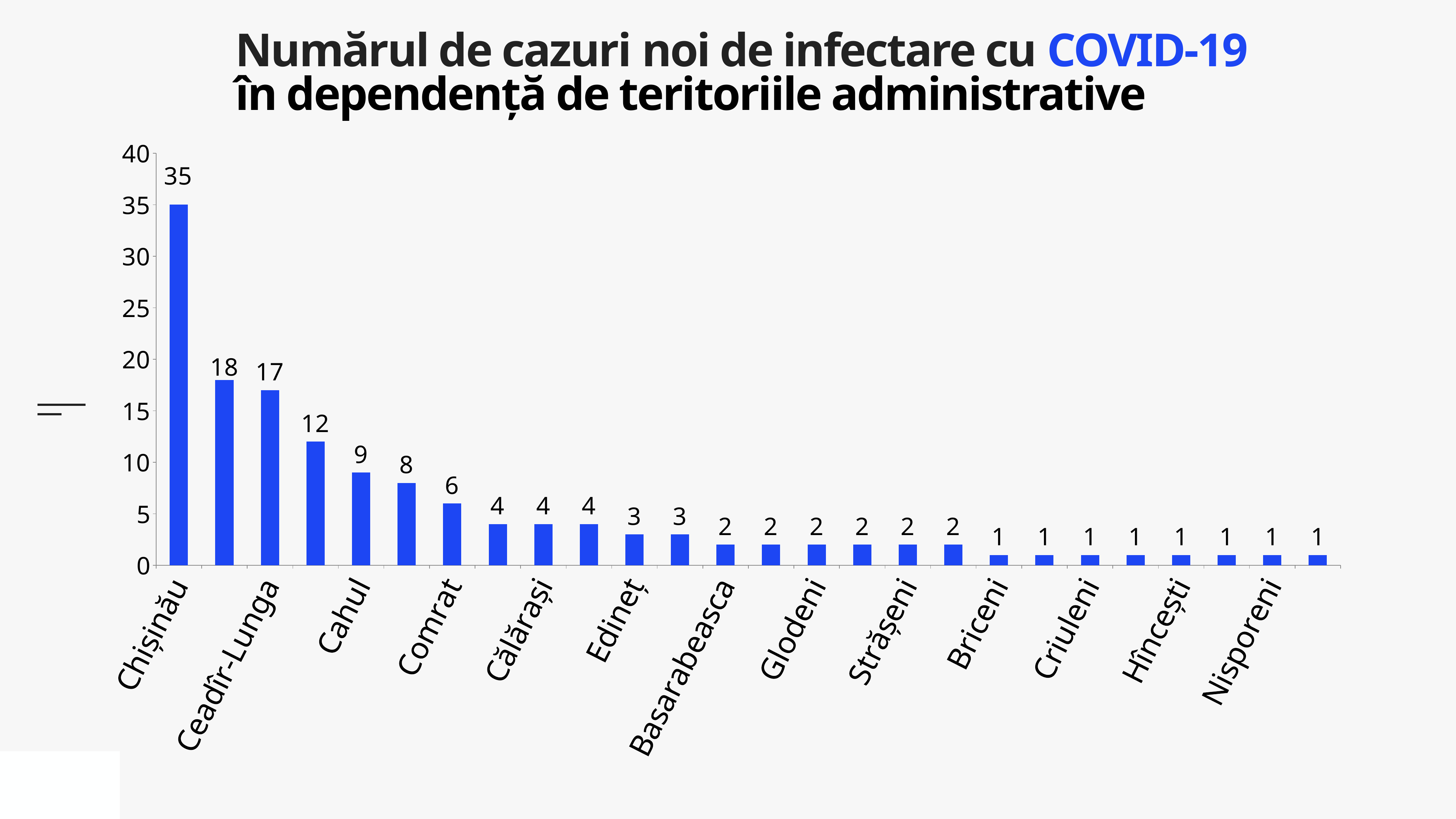
How many bars are plotted in the chart? 26 What colour are the bars in the chart? blue What is the number of new COVID-19 cases for Chișinău? 35 Is the value for Chișinău greater or less than 30? greater Do the values rise or fall from left to right along the x axis? fall Which has more new cases, Chișinău or Cahul? Chișinău Is the value for Cahul greater or less than 15? less What is the highest value shown on the vertical axis? 40 What type of chart is shown on the slide? bar chart Which has more new cases, Ceadîr-Lunga or Nisporeni? Ceadîr-Lunga How many bars have a value of 1? 8 Which administrative territory has the highest number of new cases? Chișinău